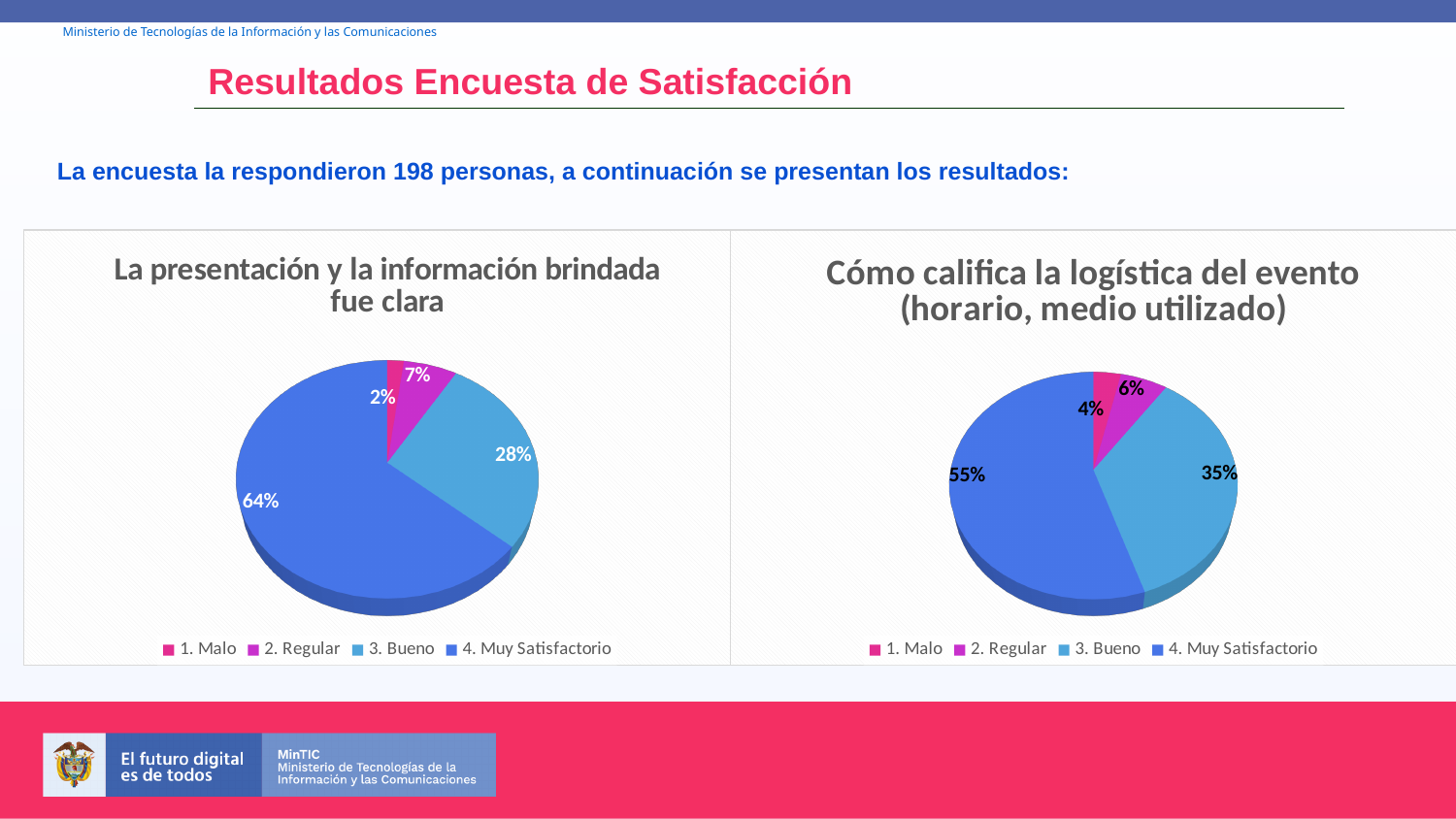
How many categories does the legend of each pie chart list? 4 Which chart has the larger share for '4. Muy Satisfactorio', the left one or the right one? The left one What type of charts are shown on the slide? Pie charts What is the smallest percentage shown in the right chart? 4% In the right chart, what is the difference between the '4. Muy Satisfactorio' and '3. Bueno' shares? 20% In the chart 'Cómo califica la logística del evento (horario, medio utilizado)', what share does '3. Bueno' have? 35% In the left chart, which category has the largest slice? 4. Muy Satisfactorio In the left chart, what is the difference between the '4. Muy Satisfactorio' and '3. Bueno' shares? 36% In the chart 'Cómo califica la logística del evento (horario, medio utilizado)', what share does '4. Muy Satisfactorio' have? 55% In the chart 'La presentación y la información brindada fue clara', what share does '3. Bueno' have? 28% In the right chart, which category has the largest slice? 4. Muy Satisfactorio